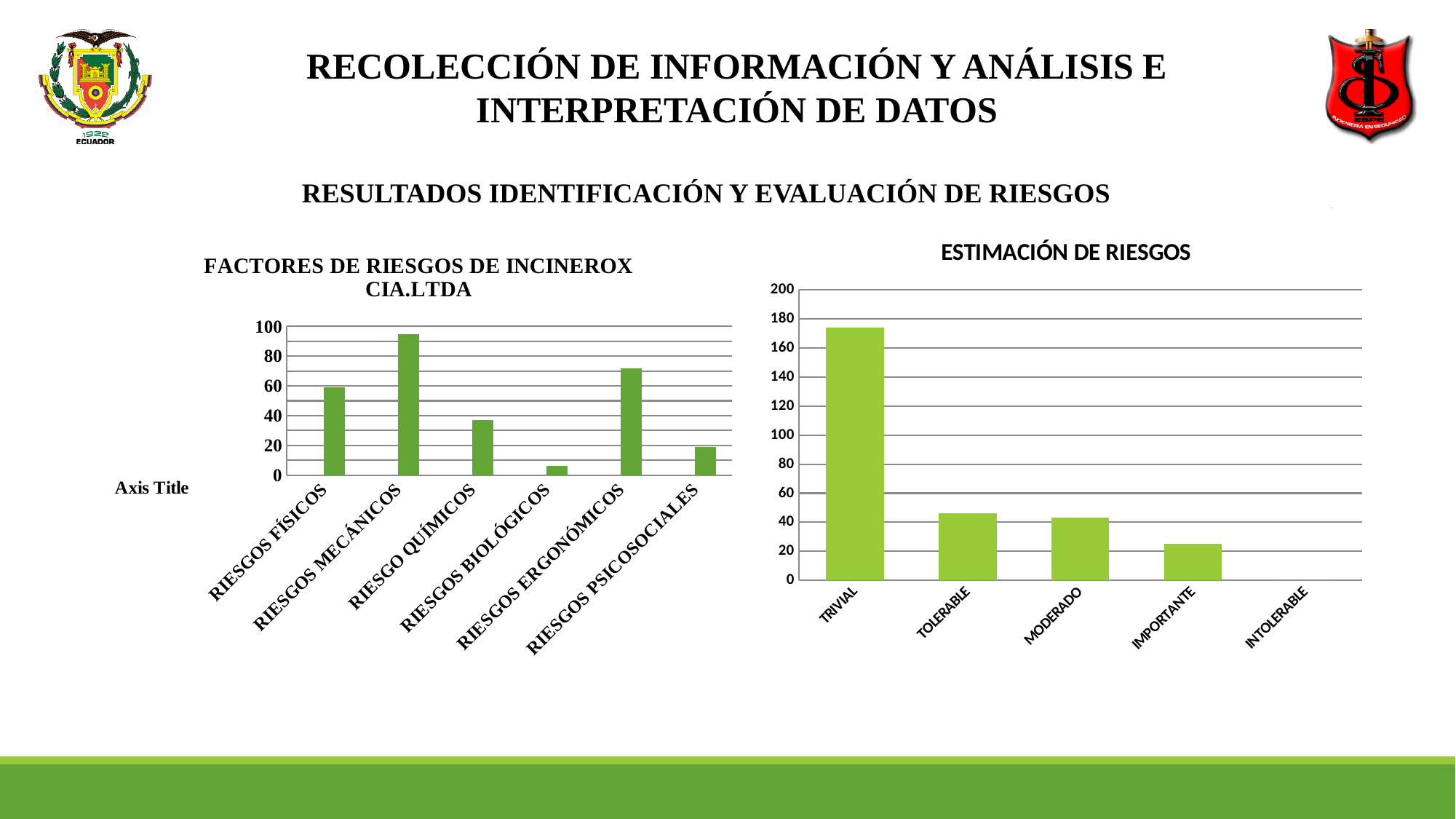
On the 'ESTIMACIÓN DE RIESGOS' chart, is the value for TRIVIAL greater or less than 160? greater On the 'ESTIMACIÓN DE RIESGOS' chart, do the values rise or fall from TRIVIAL to INTOLERABLE? fall How many categories are shown on the 'ESTIMACIÓN DE RIESGOS' chart? 5 How many categories are shown on the 'FACTORES DE RIESGOS DE INCINEROX CIA.LTDA' chart? 6 On the 'FACTORES DE RIESGOS DE INCINEROX CIA.LTDA' chart, is the value for RIESGOS ERGONÓMICOS greater or less than 60? greater What is the title of the chart on the right side of the slide? ESTIMACIÓN DE RIESGOS On the 'FACTORES DE RIESGOS DE INCINEROX CIA.LTDA' chart, which category has the lowest value? RIESGOS BIOLÓGICOS On the 'FACTORES DE RIESGOS DE INCINEROX CIA.LTDA' chart, which is larger: RIESGOS FÍSICOS or RIESGOS PSICOSOCIALES? RIESGOS FÍSICOS On the 'FACTORES DE RIESGOS DE INCINEROX CIA.LTDA' chart, which category has the highest value? RIESGOS MECÁNICOS What kind of chart is the 'FACTORES DE RIESGOS DE INCINEROX CIA.LTDA' chart? bar chart On the 'ESTIMACIÓN DE RIESGOS' chart, which category has the highest value? TRIVIAL